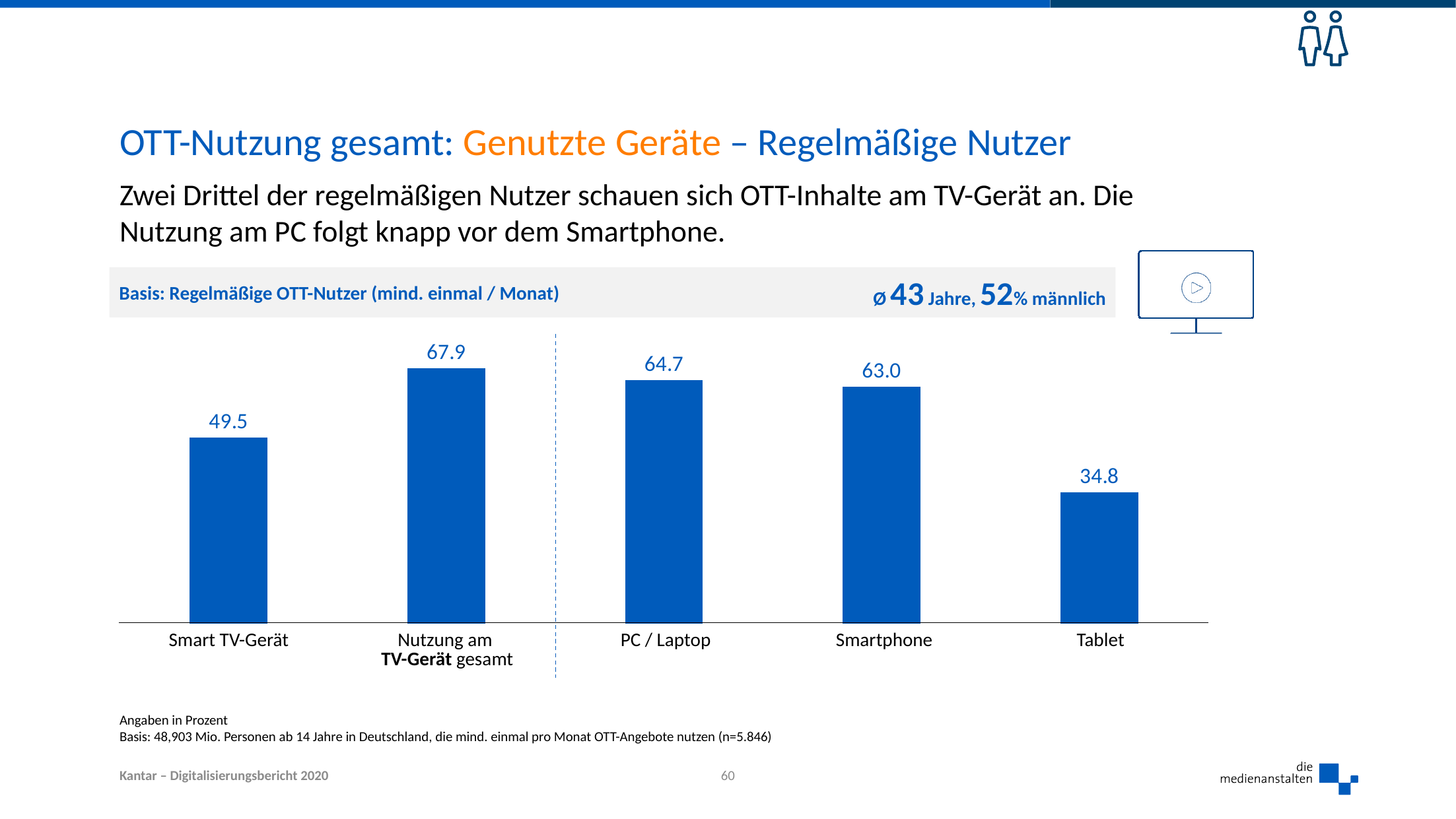
Which category has the highest value? Nutzung am TV-Gerät gesamt What is the value for Smartphone? 63.0 Which category has the lowest value? Tablet What is the difference between the values for Nutzung am TV-Gerät gesamt and Tablet? 33.1 What is the value for PC / Laptop? 64.7 What is the value for Nutzung am TV-Gerät gesamt? 67.9 What is the value for Smart TV-Gerät? 49.5 How many categories are shown in the chart? 5 Which is larger, the value for Smart TV-Gerät or the value for Smartphone? Smartphone What is the difference between the values for PC / Laptop and Smartphone? 1.7 What kind of chart is shown on the slide? Bar chart What is the value for Tablet? 34.8